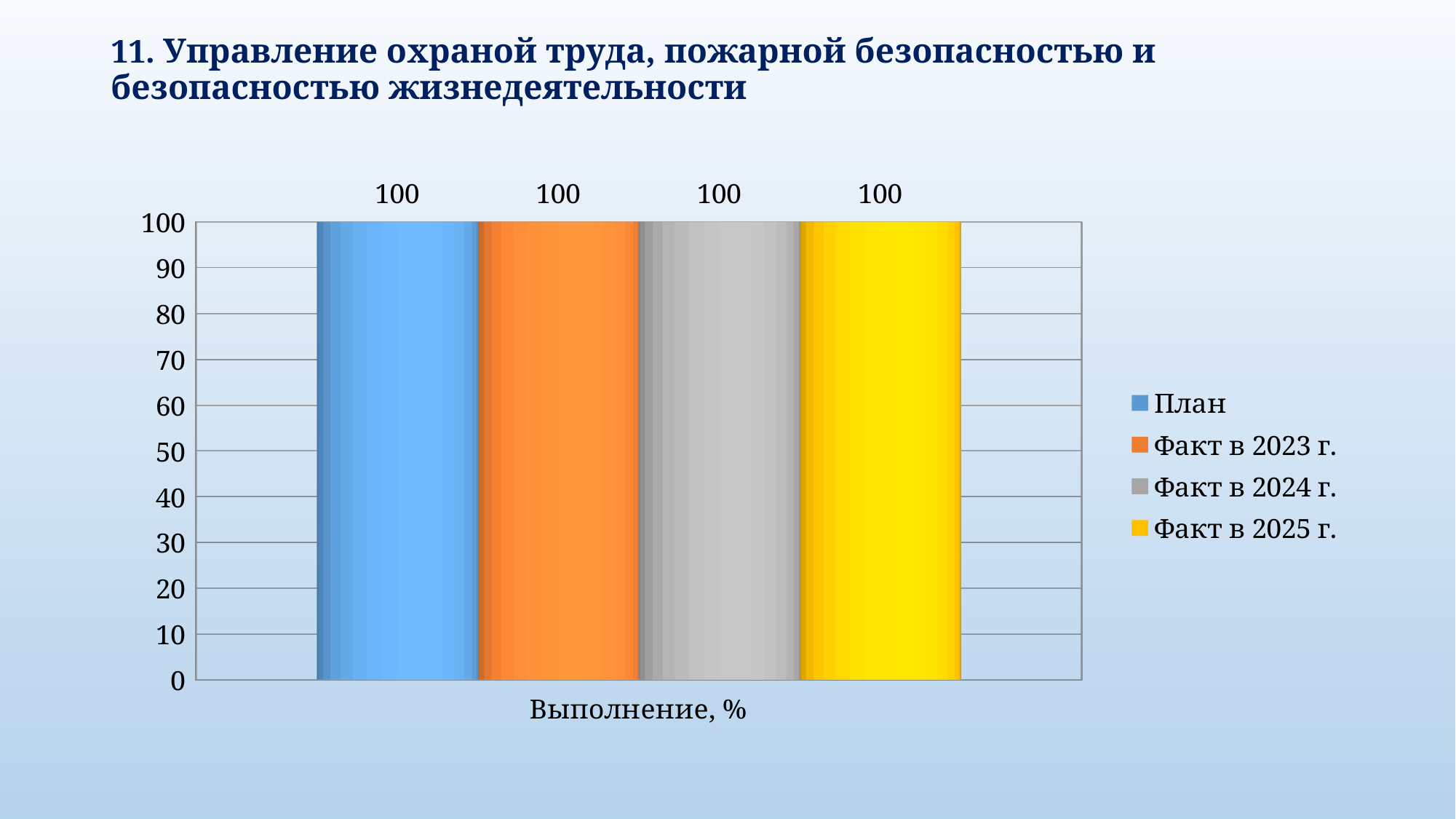
Is the value for Факт в 2024 г. greater or less than 50? greater What is the value of the Факт в 2025 г. series for Выполнение, %? 100 What is the value of the План series for Выполнение, %? 100 How many categories are shown on the x axis? 1 How many series does the legend list? 4 What is the value of the Факт в 2024 г. series for Выполнение, %? 100 What is the label of the category on the x axis? Выполнение, % What is the difference between the План value and the Факт в 2025 г. value for Выполнение, %? 0 Which series is shown in yellow in the legend? Факт в 2025 г. What is the value of the Факт в 2023 г. series for Выполнение, %? 100 What kind of chart is shown on the slide? bar chart